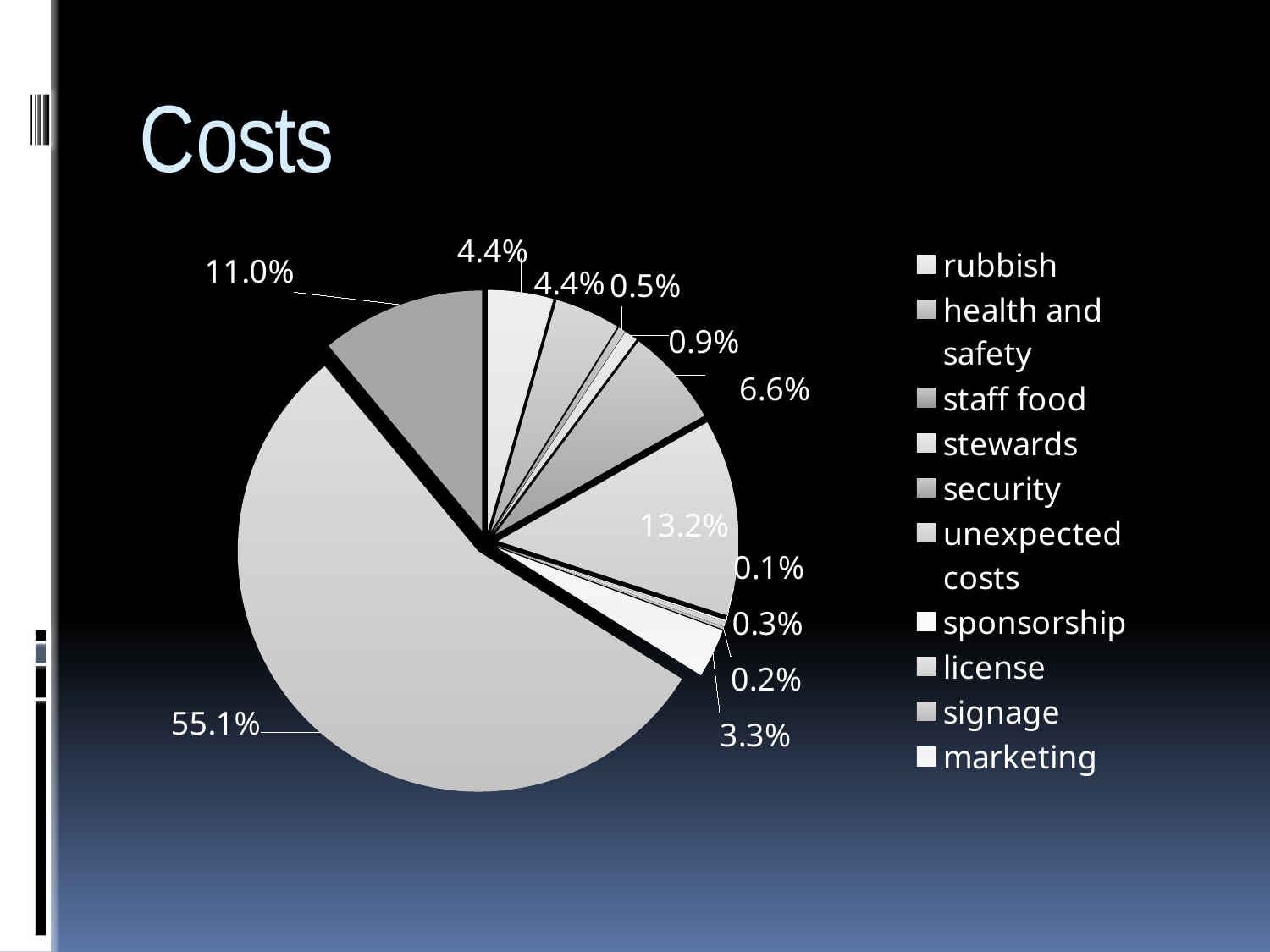
How many entries are listed in the chart's legend? 10 What kind of chart is shown on the slide? pie chart What is the share of the smallest slice in the pie chart? 0.1% Which is larger, the 6.6% slice or the 3.3% slice? the 6.6% slice What is the share of the largest slice in the pie chart? 55.1% What is the difference between the 11.0% slice and the 6.6% slice? 4.4% What is the second-largest share shown in the pie chart? 13.2% What is the title of the chart? Costs How many slices does the pie chart have? 12 What is the first entry listed in the chart's legend? rubbish Is the largest slice of the pie greater or less than 50%? greater What is the difference between the largest slice (55.1%) and the 13.2% slice? 41.9%